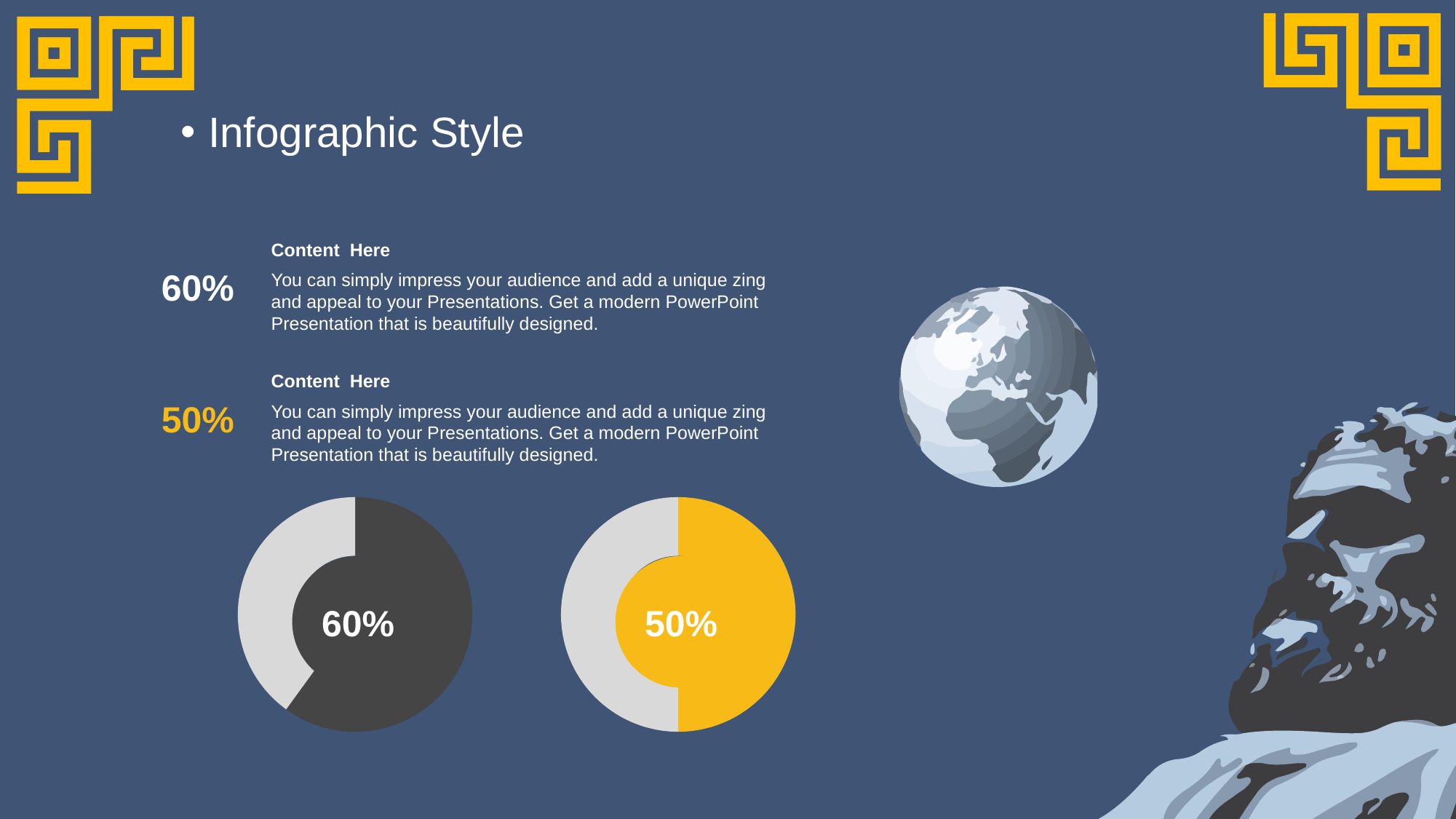
What is the difference between the percentage in the left chart and the percentage in the right chart? 10% What percentage is shown in the centre of the right doughnut chart? 50% Is the value shown in the left chart greater or less than 50%? greater What colour is the filled portion of the left chart showing 60%? dark grey What share of the left chart is taken up by the dark grey filled portion? 60% How many doughnut charts are on the slide? 2 What percentage is shown in the centre of the left doughnut chart? 60% What kind of chart is used to show the 60% and 50% values? doughnut chart What share of the right chart is left unfilled (light grey)? 50% Which chart shows the larger percentage, the left one or the right one? the left one (60%) What colour is the filled portion of the right chart showing 50%? yellow What share of the left chart is left unfilled (light grey)? 40%